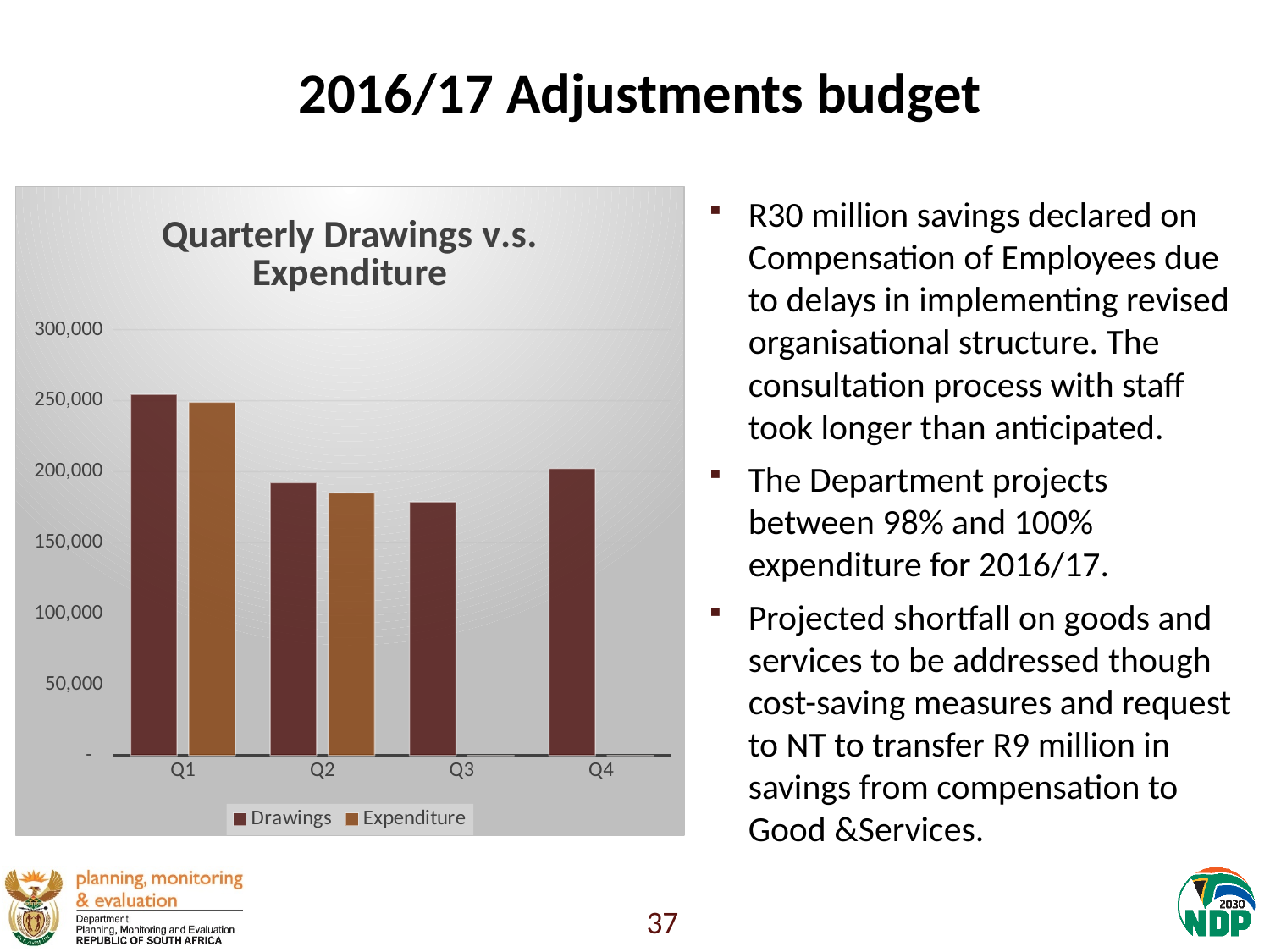
Is the Drawings value for Q1 greater or less than 250,000? greater Do the Drawings values rise or fall from Q1 to Q3? fall Which series is shown in the lighter brown/orange colour in the chart? Expenditure What kind of chart is shown on the slide? Bar chart Which is larger, the Drawings value for Q1 or the Drawings value for Q4? Q1 Is the Expenditure value for Q2 greater or less than 200,000? less How many quarters are shown on the x axis of the chart? 4 How many series does the chart legend list? 2 Which quarter has the lowest Drawings value? Q3 Which quarter has the highest Drawings value? Q1 What is the title of the chart? Quarterly Drawings v.s. Expenditure